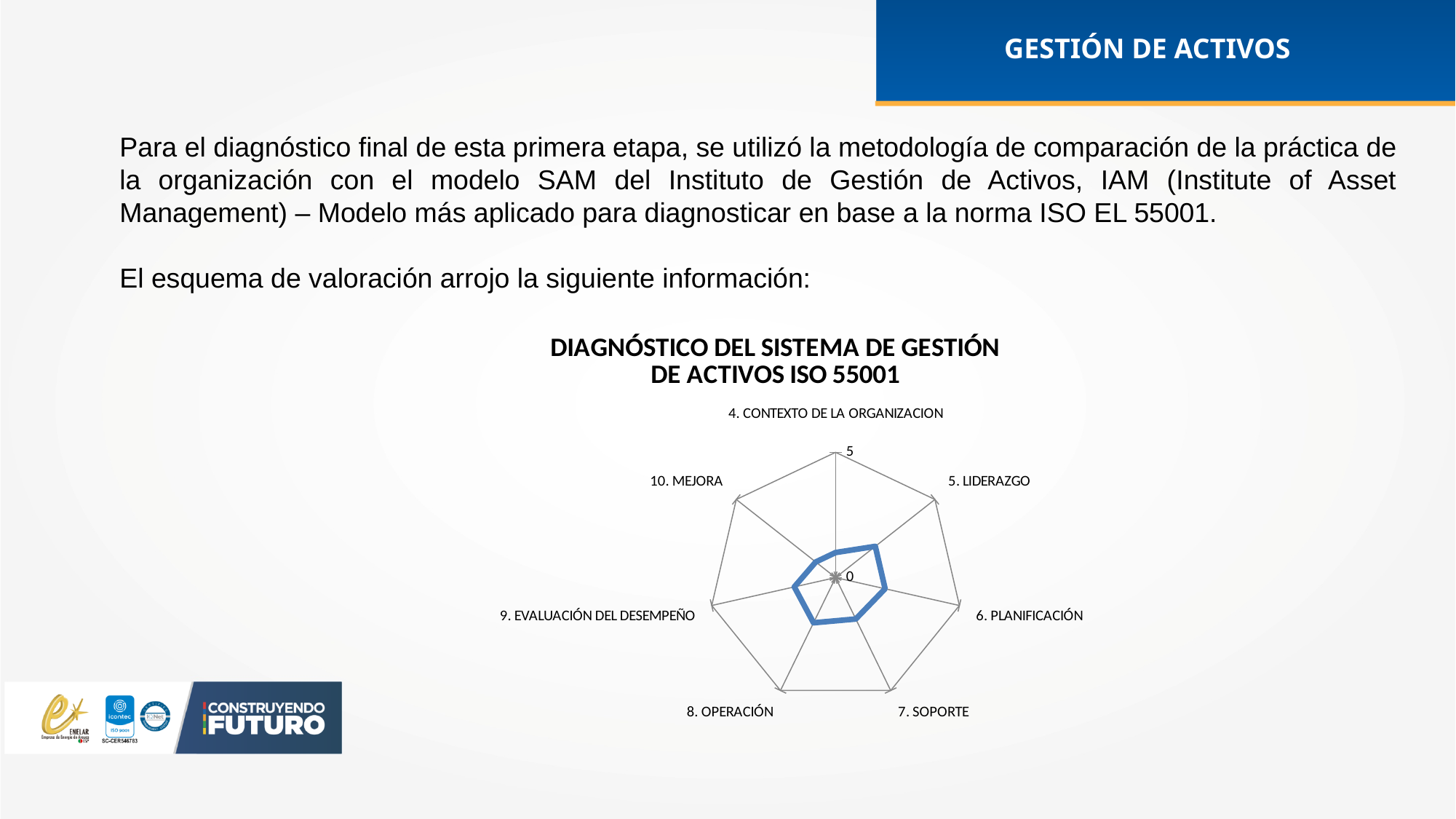
What is the title of the chart? DIAGNÓSTICO DEL SISTEMA DE GESTIÓN DE ACTIVOS ISO 55001 Is the value for 9. EVALUACIÓN DEL DESEMPEÑO greater or less than 5? less Is the value for 8. OPERACIÓN greater or less than 5? less Is the value for 7. SOPORTE greater or less than 5? less What is the maximum value shown on the chart's axis scale? 5 What kind of chart is shown on the slide? Radar chart How many categories (axes) does the radar chart have? 7